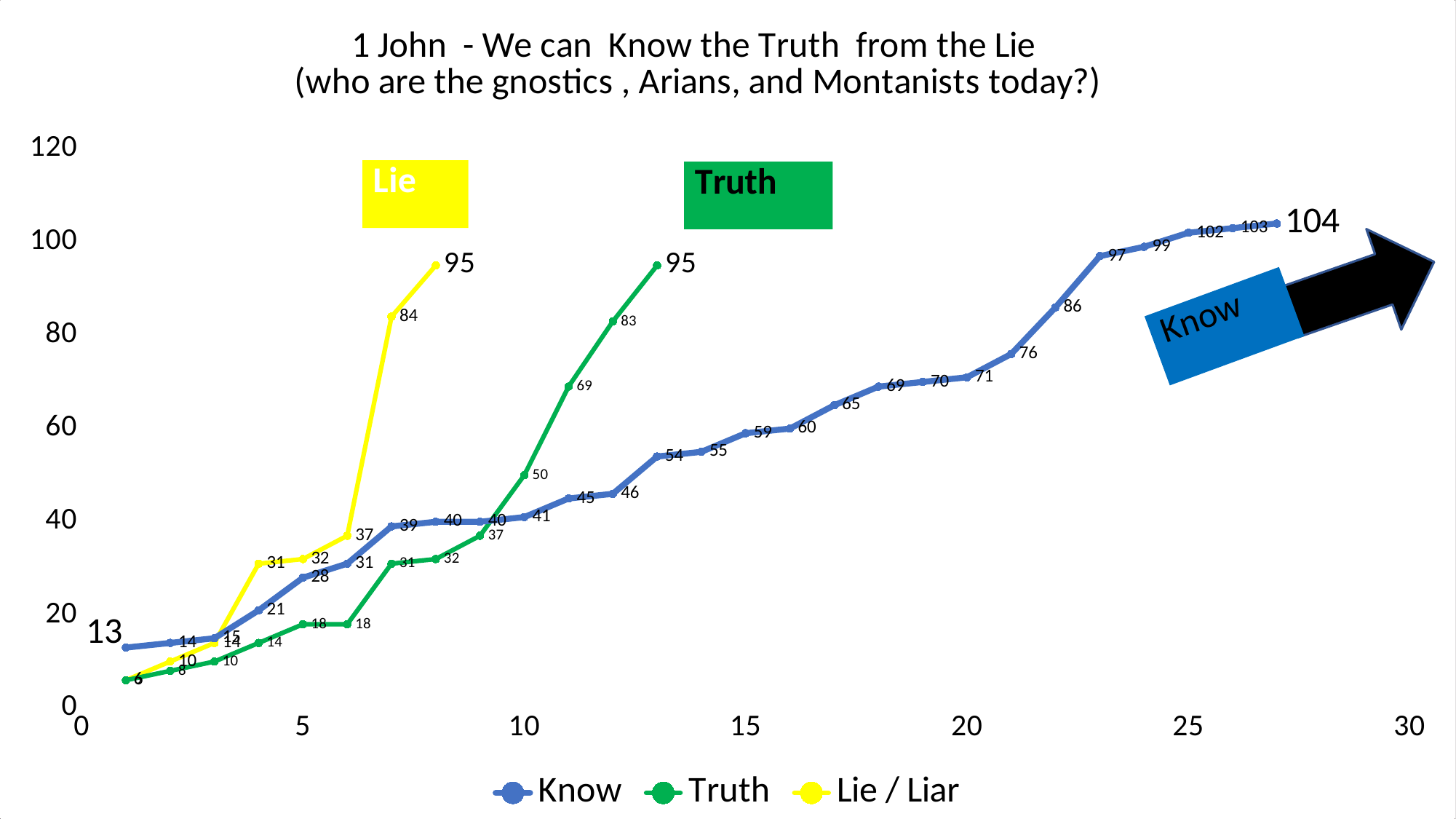
What is the final (highest) value reached by the Know series? 104 What is the value of the Lie / Liar series at x = 7? 84 What is the final value reached by the Lie / Liar series? 95 What are the three series names listed in the legend? Know, Truth, Lie / Liar At x = 12, which series has the larger value, Truth (83) or Know (46)? Truth What is the value of the Truth series at x = 10? 50 Do the values of the Know series rise or fall as x increases? rise What is the first value of the Know series, at x = 1? 13 What is the final value reached by the Truth series? 95 What kind of chart is shown on the slide? line chart What is the difference between the final value of the Know series (104) and the final value of the Truth series (95)? 9 How many series does the legend list? 3